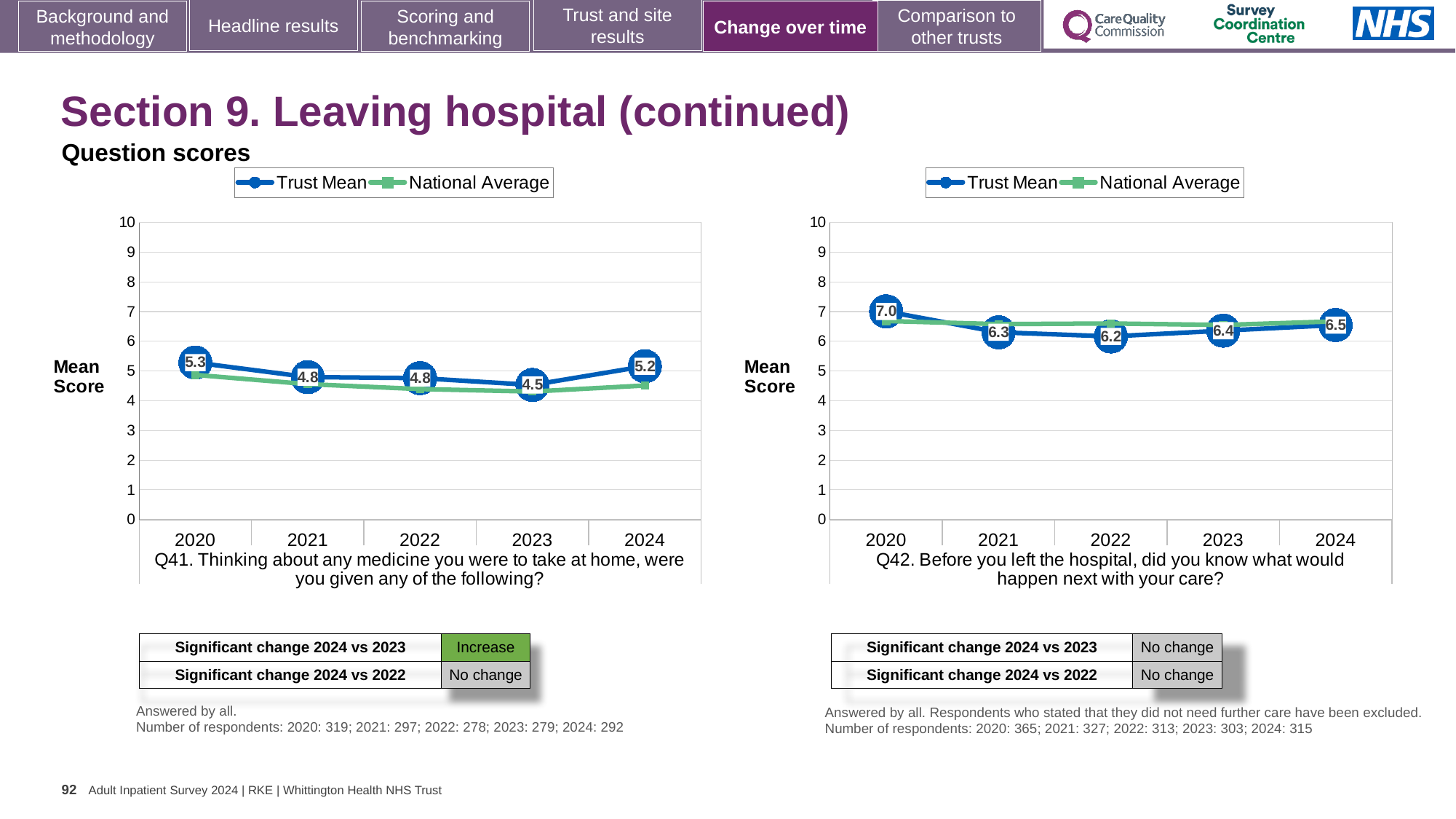
In the Q42 chart (right), what is the Trust Mean score for 2022? 6.2 In the Q41 chart (left), what is the Trust Mean score for 2023? 4.5 How many years are plotted on the x axis of the Q41 chart (left)? 5 In the Q42 chart (right), what is the difference between the Trust Mean scores for 2020 and 2021? 0.7 How many series does the legend of the Q42 chart (right) list? 2 What type of chart is the Q41 chart (left)? Line chart In the Q41 chart (left), which year has the lowest Trust Mean score? 2023 In the Q42 chart (right), which year has the highest Trust Mean score? 2020 In the Q41 chart (left), what is the Trust Mean score for 2024? 5.2 In the Q42 chart (right), is the Trust Mean score for 2021 greater or less than 7? less In the Q42 chart (right), what is the Trust Mean score for 2020? 7.0 In the Q41 chart (left), what is the difference between the Trust Mean scores for 2024 and 2023? 0.7